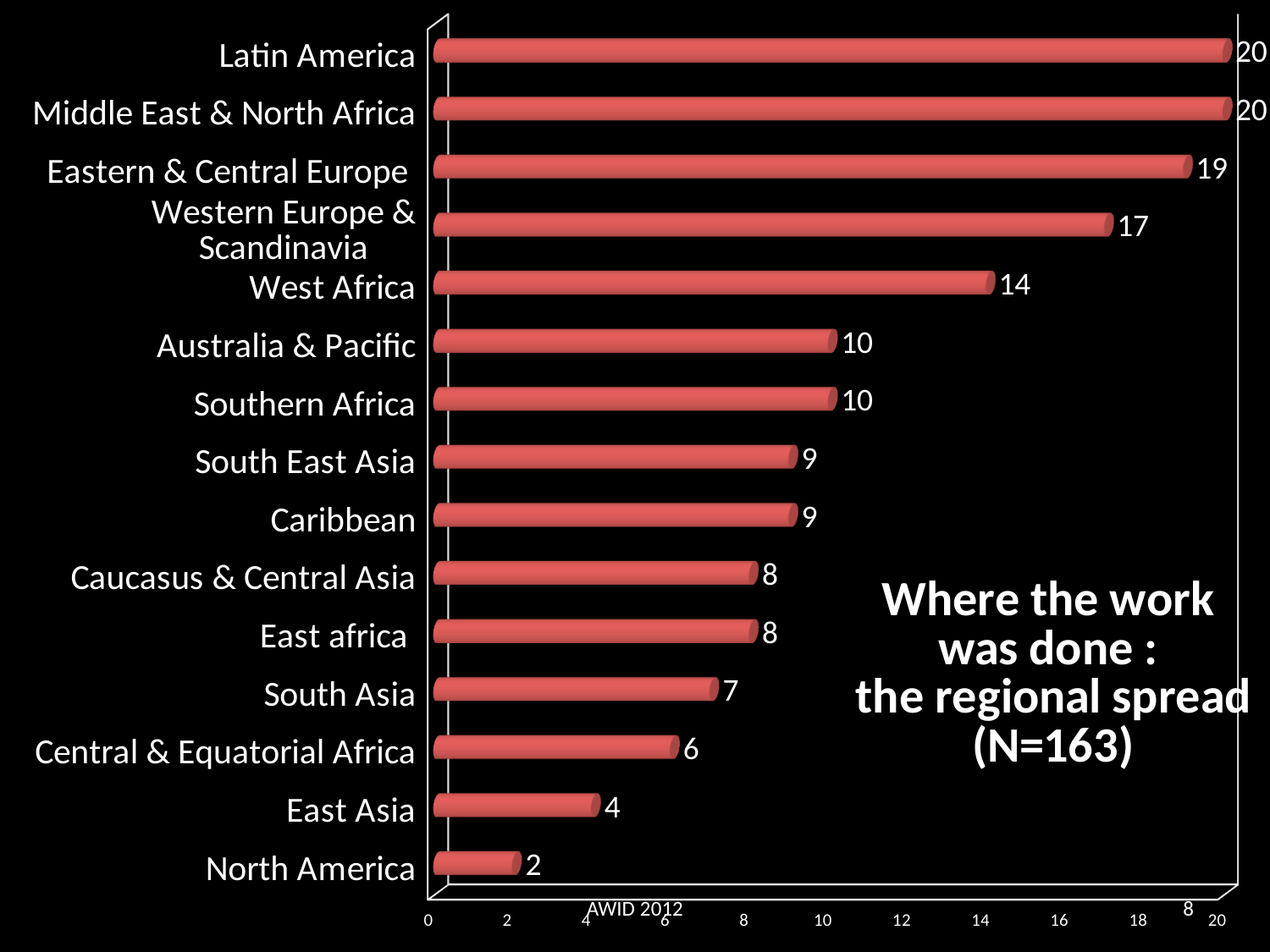
What is the N value given in the chart title? 163 What is the value for Eastern & Central Europe? 19 What kind of chart is shown on the slide? Bar chart What is the difference between the values for Latin America and North America? 18 What is the value for East Asia? 4 What is the difference between the values for Western Europe & Scandinavia and South Asia? 10 How many regions are shown in the chart? 15 What is the value for Central & Equatorial Africa? 6 Which region has the lowest value? North America What is the value for West Africa? 14 Which is larger, the value for Southern Africa or the value for Caribbean? Southern Africa Which is larger, the value for East Asia or the value for Caucasus & Central Asia? Caucasus & Central Asia